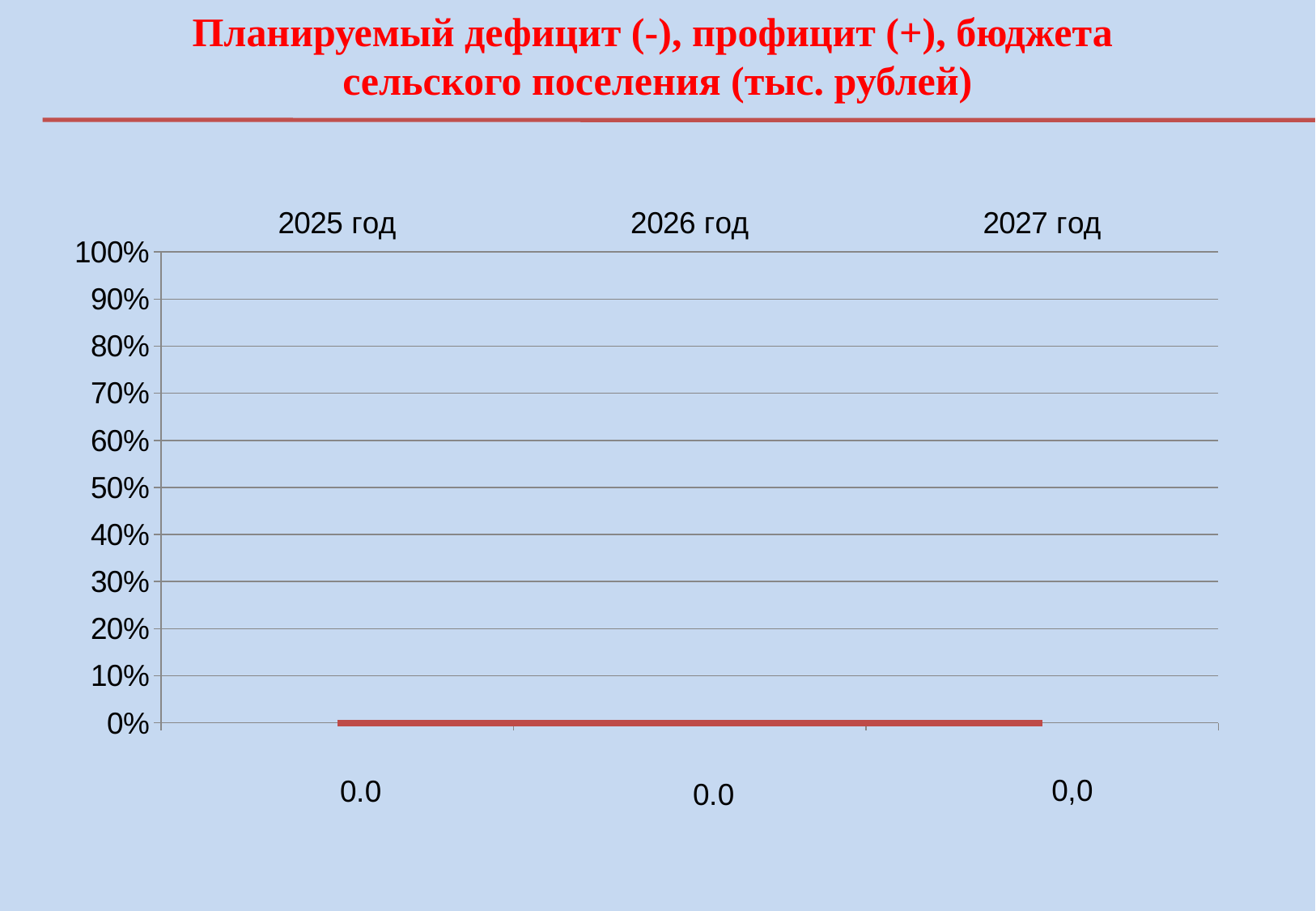
Is the value for 2025 год greater or less than 10%? less What is the difference between the values for 2025 год and 2026 год? 0.0 What is the title of the chart? Планируемый дефицит (-), профицит (+), бюджета сельского поселения (тыс. рублей) What is the value shown for 2027 год? 0,0 How many years (categories) are plotted on the chart? 3 What is the highest tick shown on the vertical axis? 100% Do the values rise, fall, or stay flat from 2025 год to 2027 год? stay flat What is the value shown for 2026 год? 0.0 What is the value shown for 2025 год? 0.0 Is the value for 2027 год greater or less than 50%? less